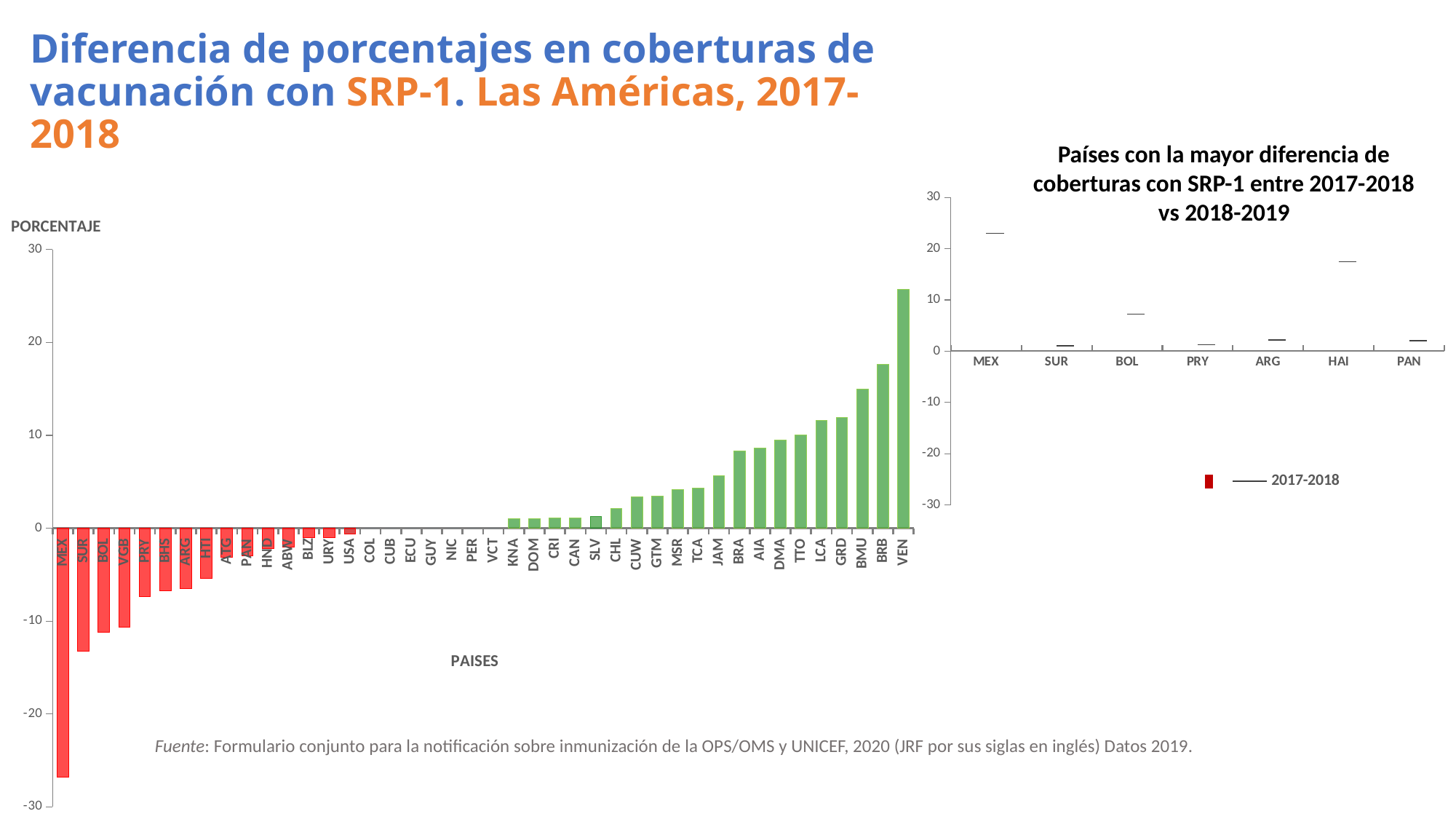
On the left chart, which country has the highest value? VEN On the left chart, is the value for MEX greater or less than -20? less On the left chart, which is larger, the value for BRB or the value for BMU? BRB On the left chart, is the value for VEN greater or less than 20? greater What kind of chart is the left chart? bar chart On the left chart, do the values rise or fall from left to right along the x axis? rise On the chart titled 'Países con la mayor diferencia de coberturas con SRP-1 entre 2017-2018 vs 2018-2019', how many countries are shown on the x axis? 7 On the left chart, is the value for SUR greater or less than -10? less On the left chart, which country has the lowest value? MEX On the chart titled 'Países con la mayor diferencia de coberturas con SRP-1 entre 2017-2018 vs 2018-2019', which country has the highest value? MEX On the chart titled 'Países con la mayor diferencia de coberturas con SRP-1 entre 2017-2018 vs 2018-2019', how many series does the legend list? 1